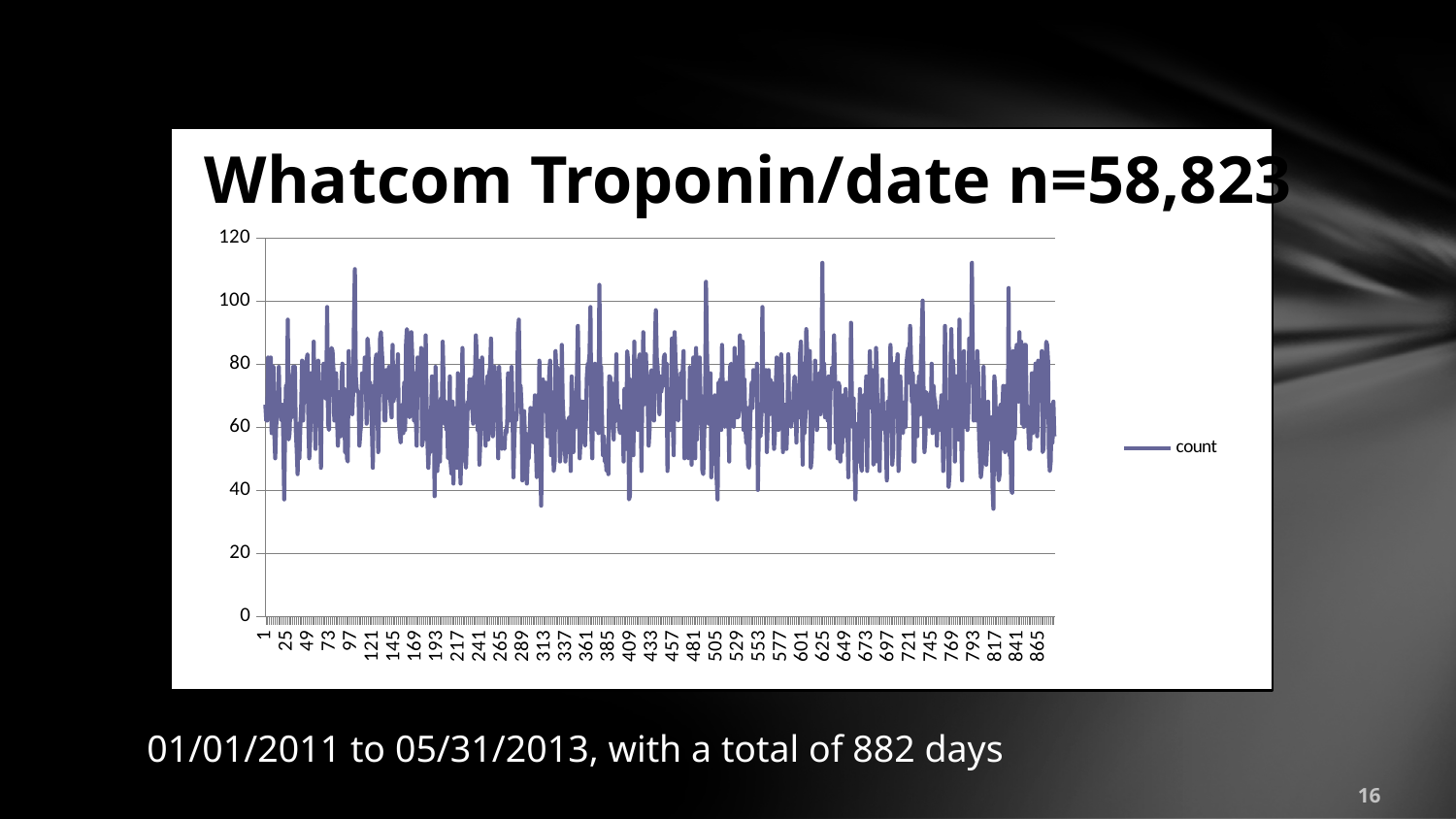
What is the last tick label shown on the x axis? 865 What is the name of the series shown in the legend? count Is the highest value plotted on the chart greater or less than 100? greater What is the highest tick value shown on the y axis? 120 Does the count show a clear rising or falling trend along the x axis? neither; it fluctuates around a roughly constant level What kind of chart is shown on the slide? line chart Is the lowest value plotted on the chart greater or less than 40? less How many series does the legend list? 1 What is the title of the chart? Whatcom Troponin/date n=58,823